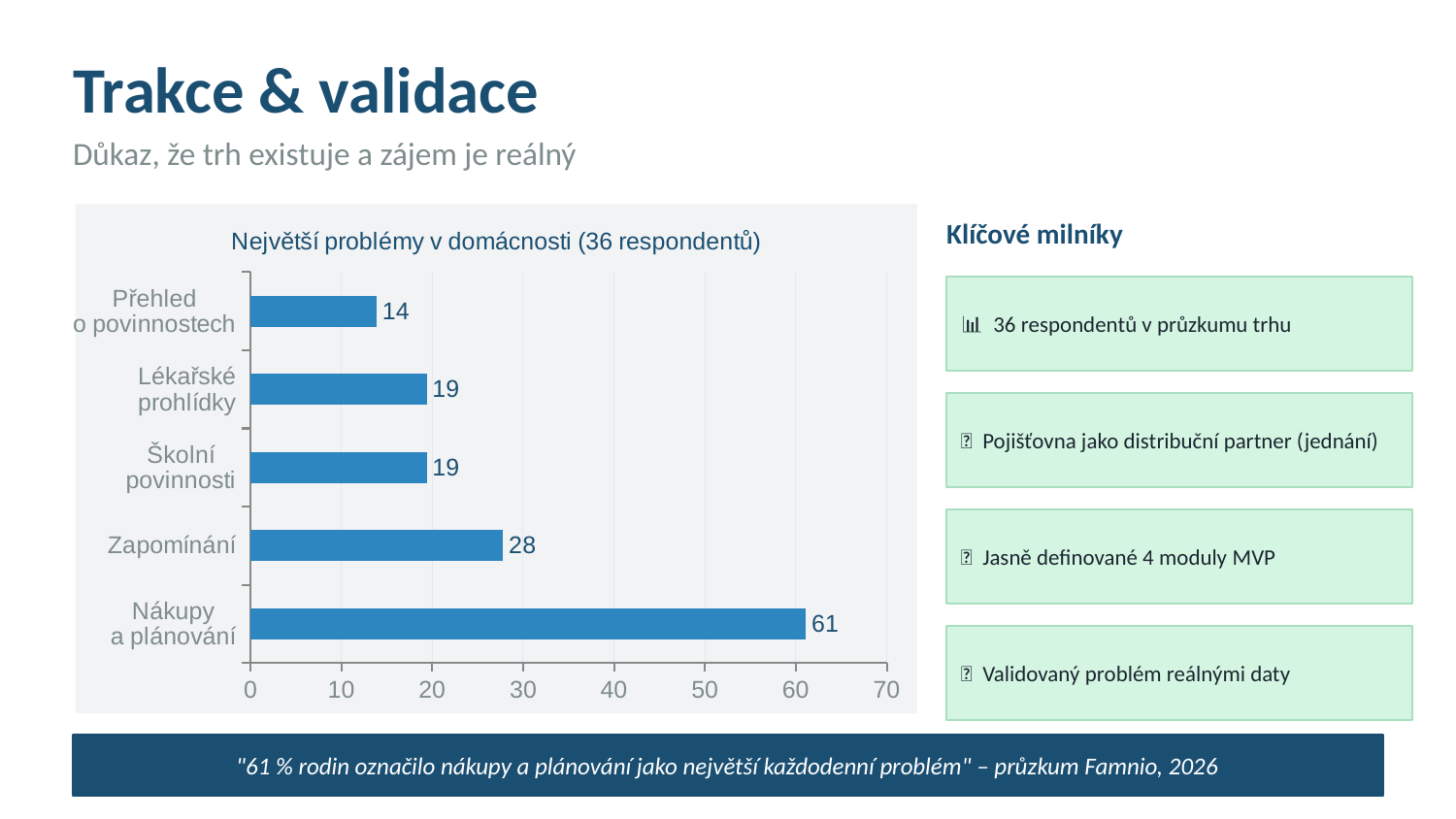
How many categories are shown in the chart? 5 What is the value for Nákupy a plánování? 61 Which is larger, the value for Zapomínání or the value for Školní povinnosti? Zapomínání Which category has the highest value? Nákupy a plánování Is the value for Nákupy a plánování greater or less than 50? greater What kind of chart is shown on the slide? Bar chart What is the value for Zapomínání? 28 What is the value for Lékařské prohlídky? 19 Which category has the lowest value? Přehled o povinnostech What is the title of the chart? Největší problémy v domácnosti (36 respondentů) What is the value for Přehled o povinnostech? 14 What is the difference between the values for Nákupy a plánování and Zapomínání? 33